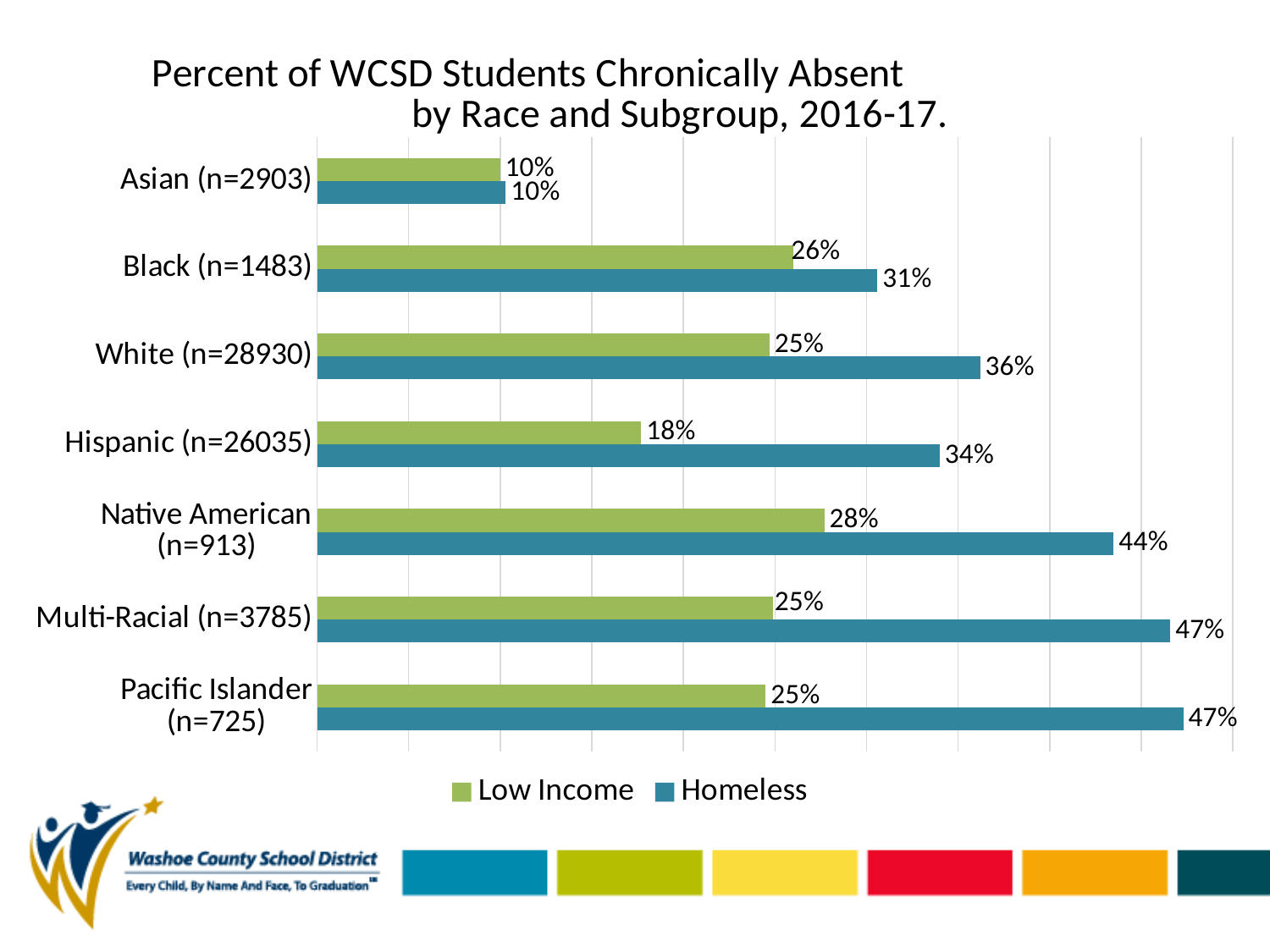
What is the difference between the Homeless values for White (n=28930) and Black (n=1483)? 5% How many race categories are shown on the chart? 7 What is the Low Income value for Hispanic (n=26035)? 18% Which category has the lowest Homeless value? Asian (n=2903) Which is larger, the Homeless value for Hispanic (n=26035) or the Homeless value for White (n=28930)? White (n=28930) What kind of chart is shown on the slide? Bar chart What is the difference between the Homeless and Low Income values for Multi-Racial (n=3785)? 22% Which category has the highest Low Income value? Native American (n=913) What is the Low Income value for White (n=28930)? 25% What is the Homeless value for Native American (n=913)? 44% How many series does the legend list? 2 What is the Homeless value for Black (n=1483)? 31%